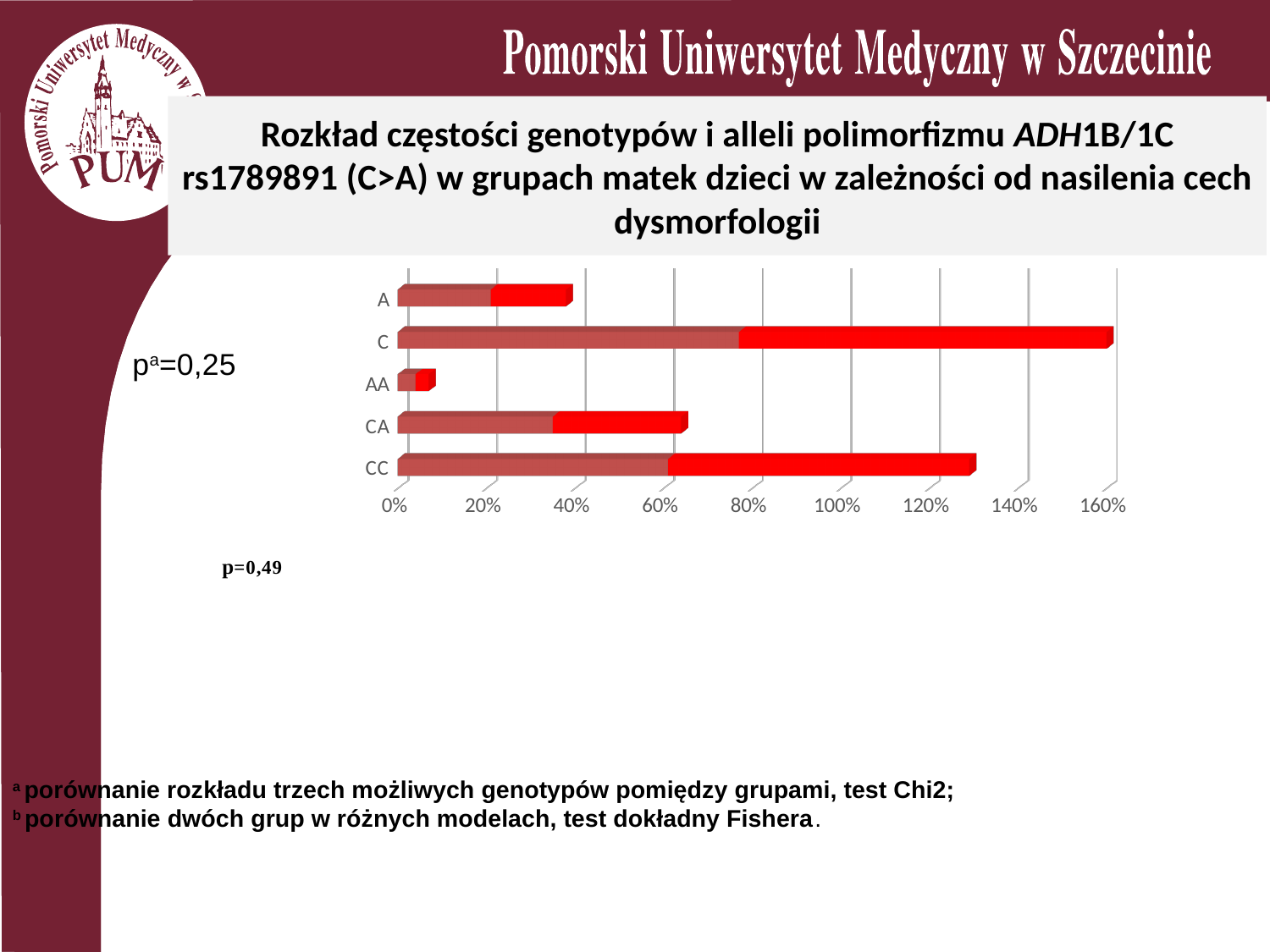
What kind of chart is shown on the slide? bar chart Which bar is longer, A or CA? CA Which bar is longer, C or CC? C Which category has the longest bar in the chart? C Is the total bar length for C greater or less than 140%? greater Which category has the shortest bar in the chart? AA Is the total bar length for CA greater or less than 80%? less What is the highest value labelled on the horizontal axis of the chart? 160% Which bar is longer, CC or CA? CC How many categories are shown on the vertical axis of the chart? 5 Is the total bar length for CC greater or less than 120%? greater